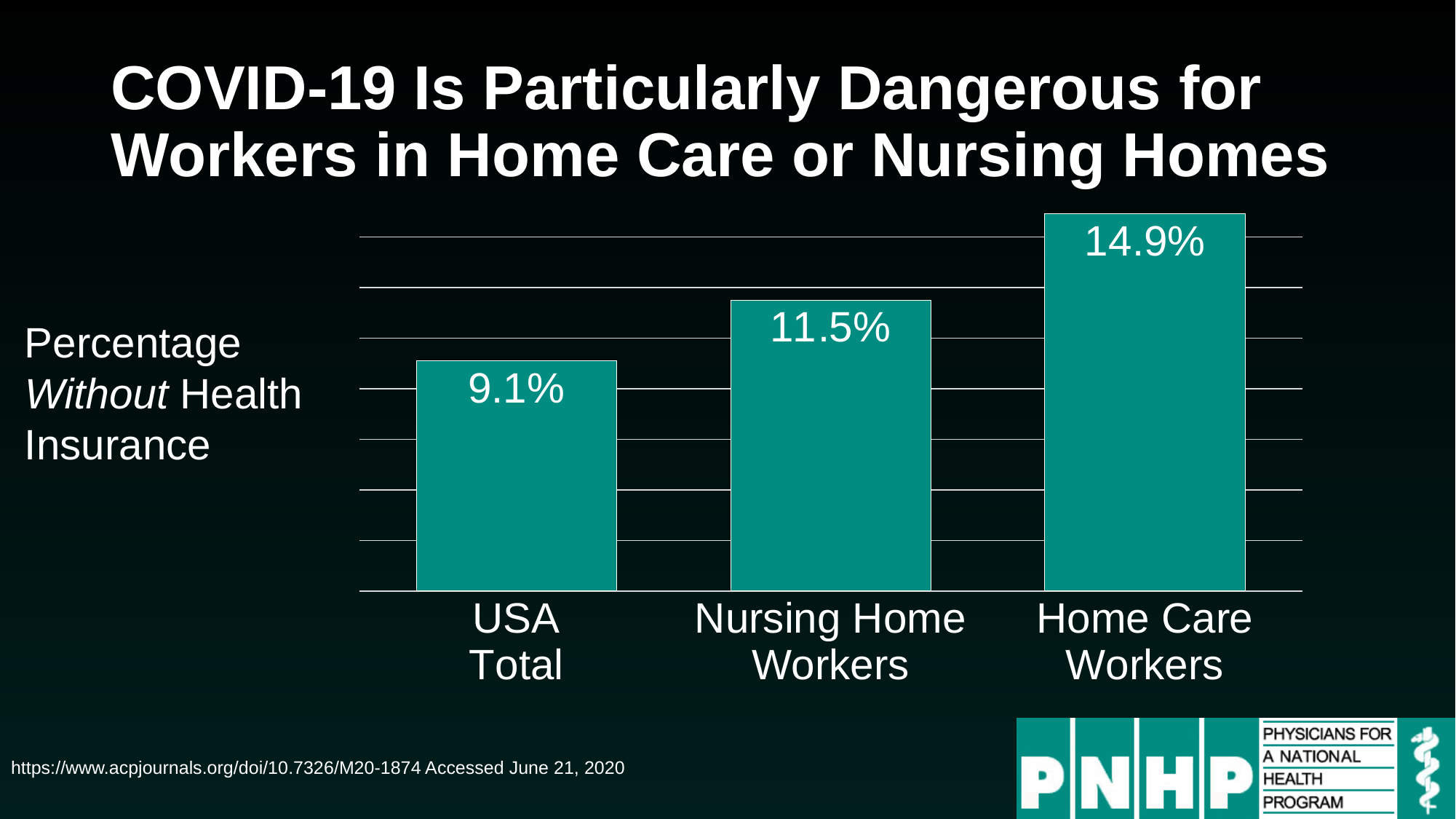
Which category has the highest percentage without health insurance? Home Care Workers Which category has the lowest percentage without health insurance? USA Total What kind of chart is shown on the slide? Bar chart Do the values rise or fall from left to right across the categories? Rise Which is larger, the value for Nursing Home Workers or the value for Home Care Workers? Home Care Workers What is the percentage without health insurance for Nursing Home Workers? 11.5% What is the difference in percentage points between Nursing Home Workers and USA Total? 2.4 What is the percentage without health insurance for Home Care Workers? 14.9% What is the percentage without health insurance for USA Total? 9.1% What is the difference in percentage points between Home Care Workers and USA Total? 5.8 What quantity does the chart measure, according to the label to the left of the chart? Percentage Without Health Insurance How many categories are shown in the chart? 3